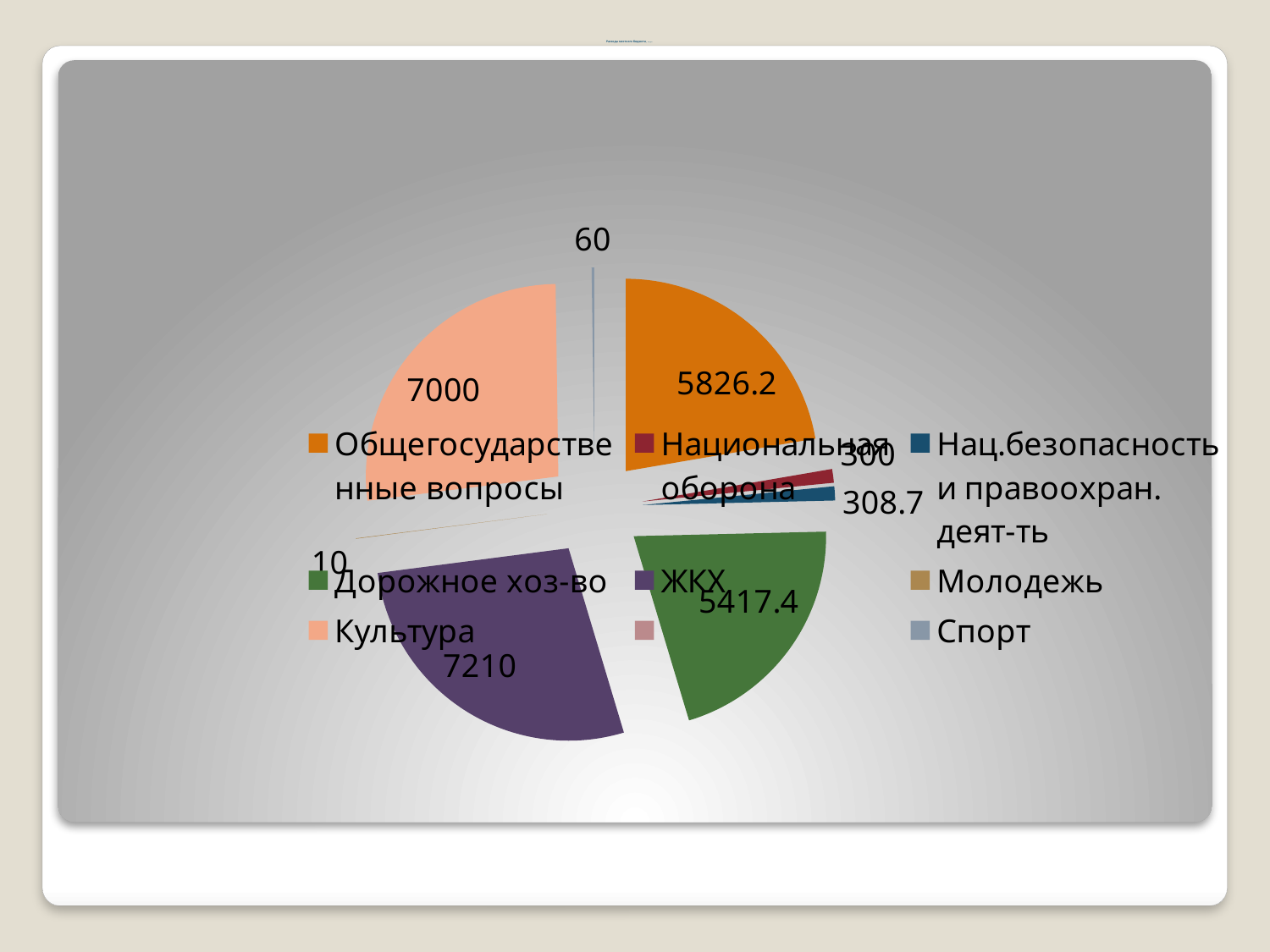
What is the value for Дорожное хоз-во? 5417.4 What kind of chart is shown on the slide? pie chart What colour is the slice for Дорожное хоз-во? green What is the value for Культура? 7000 Which is larger, the value for Культура or the value for Общегосударственные вопросы? Культура What is the value for ЖКХ? 7210 What is the value for Национальная оборона? 300 What is the difference between the values for Общегосударственные вопросы and Дорожное хоз-во? 408.8 What is the value for Общегосударственные вопросы? 5826.2 What is the value for Нац.безопасность и правоохран. деят-ть? 308.7 Which category has the largest slice? ЖКХ What is the difference between the values for ЖКХ and Культура? 210